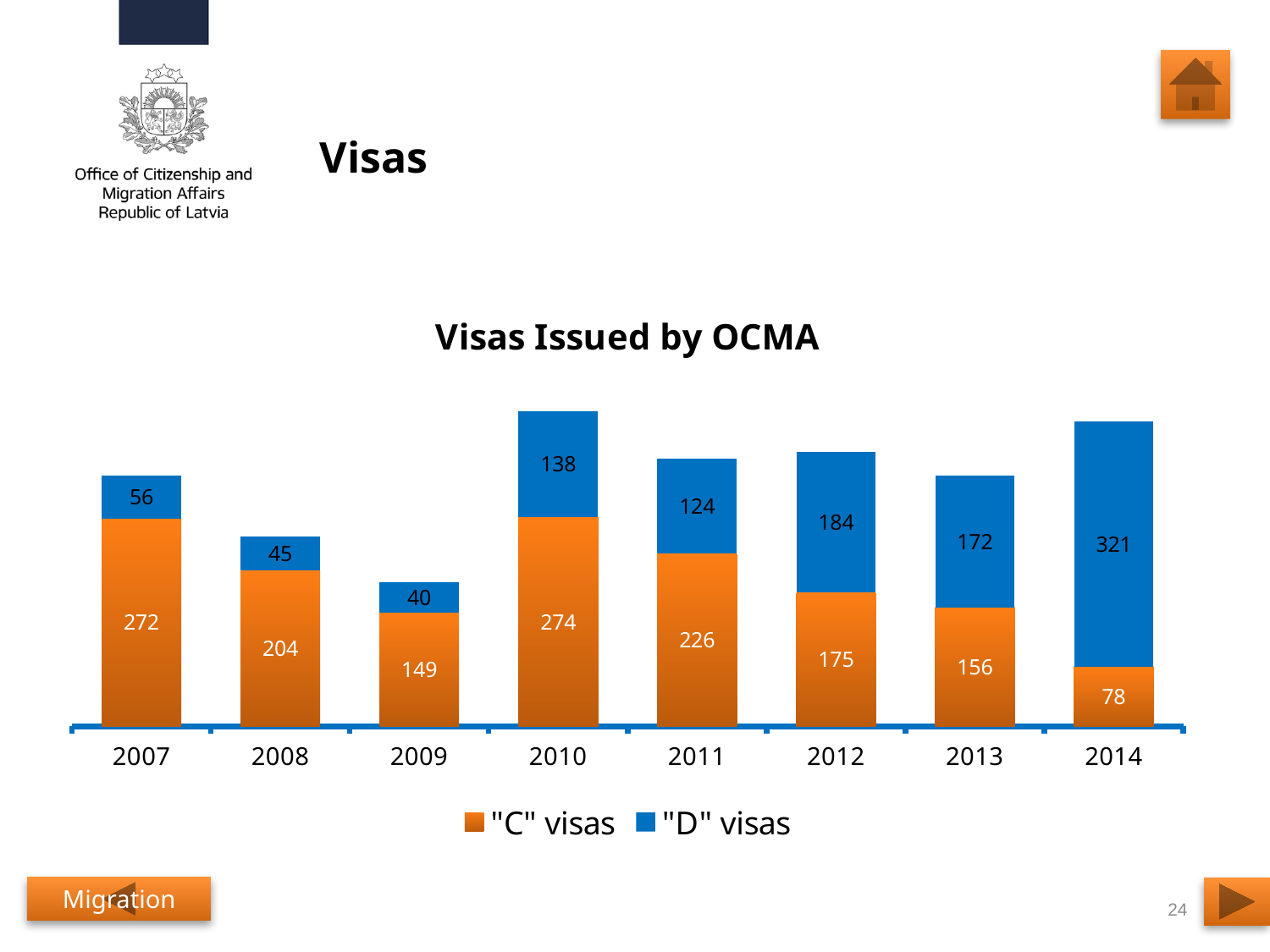
Do the "D" visa values rise or fall from 2011 to 2014? Rise overall (124 to 321), though they dip in 2013 (184 to 172) In which year were the fewest "C" visas issued? 2014 What is the total number of visas issued in 2010 ("C" and "D" combined)? 412 In which year were the fewest "D" visas issued? 2009 Which is larger in 2012: the number of "C" visas or the number of "D" visas? "D" visas What is the difference between the number of "D" visas issued in 2014 and in 2013? 149 How many series does the legend list? 2 How many "D" visas were issued in 2014? 321 In which year were the most "D" visas issued? 2014 What kind of chart is shown on the slide? Stacked bar chart How many "C" visas were issued in 2010? 274 How many years are shown on the x axis? 8